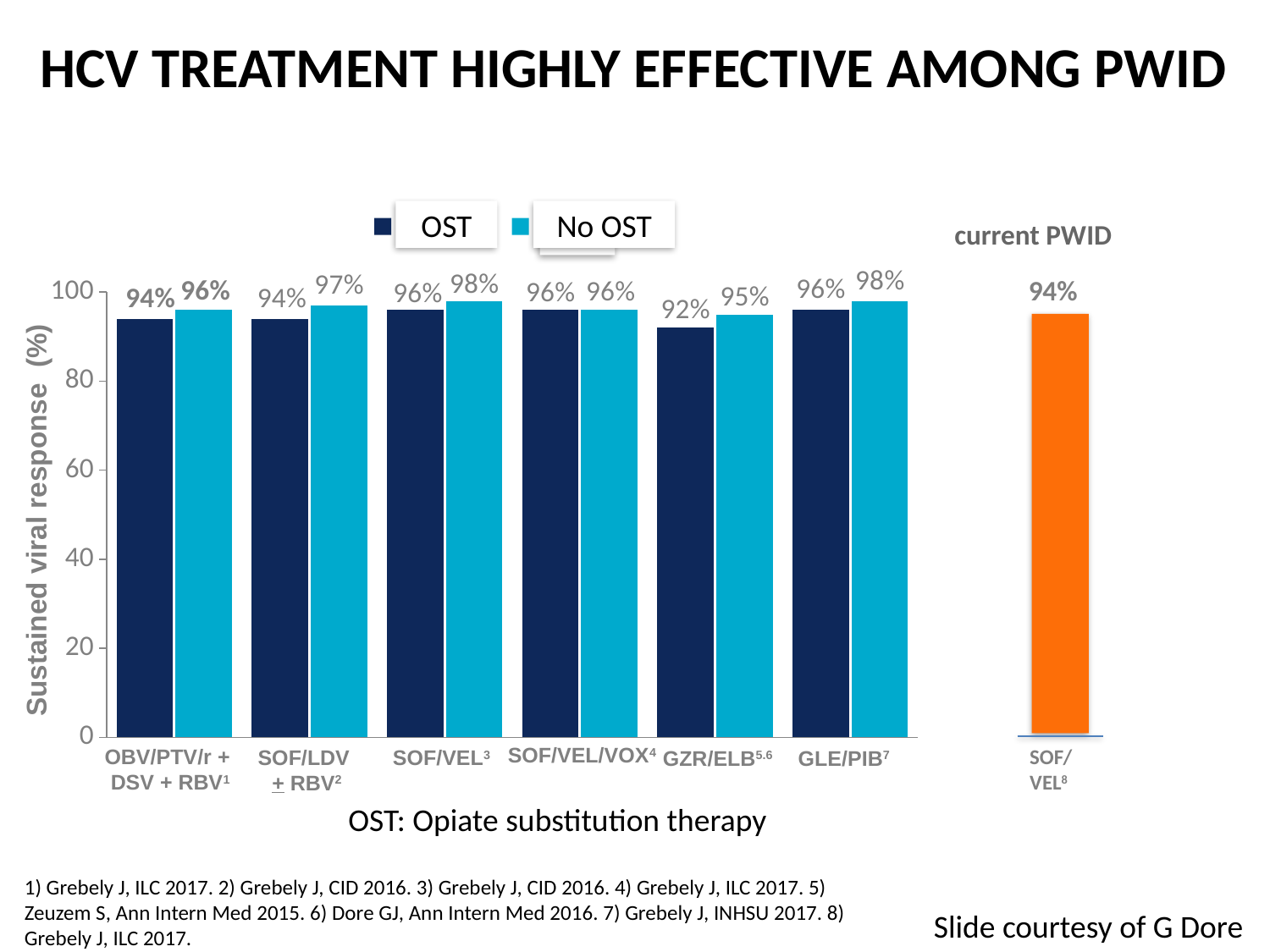
In the main OST/No OST chart, how many series does the legend list? 2 In the main OST/No OST chart, what is the difference between the No OST and OST values for SOF/LDV ± RBV? 3% In the main OST/No OST chart, which is larger for GZR/ELB: the OST value or the No OST value? No OST What type of chart is used to show sustained viral response on this slide? Bar chart In the main OST/No OST chart, what is the sustained viral response for the No OST group with SOF/LDV ± RBV? 97% In the main OST/No OST chart, what is the sustained viral response for the No OST group with GLE/PIB? 98% In the main OST/No OST chart, how many treatment regimens are shown on the x axis? 6 In the current PWID chart on the right, what is the sustained viral response for SOF/VEL? 94% In the main OST/No OST chart, which regimen has the lowest sustained viral response in the No OST group? GZR/ELB In the main OST/No OST chart, which legend entry is shown in dark navy blue? OST In the main OST/No OST chart, which regimen has the lowest sustained viral response in the OST group? GZR/ELB In the main OST/No OST chart, what is the sustained viral response for the OST group with GZR/ELB? 92%